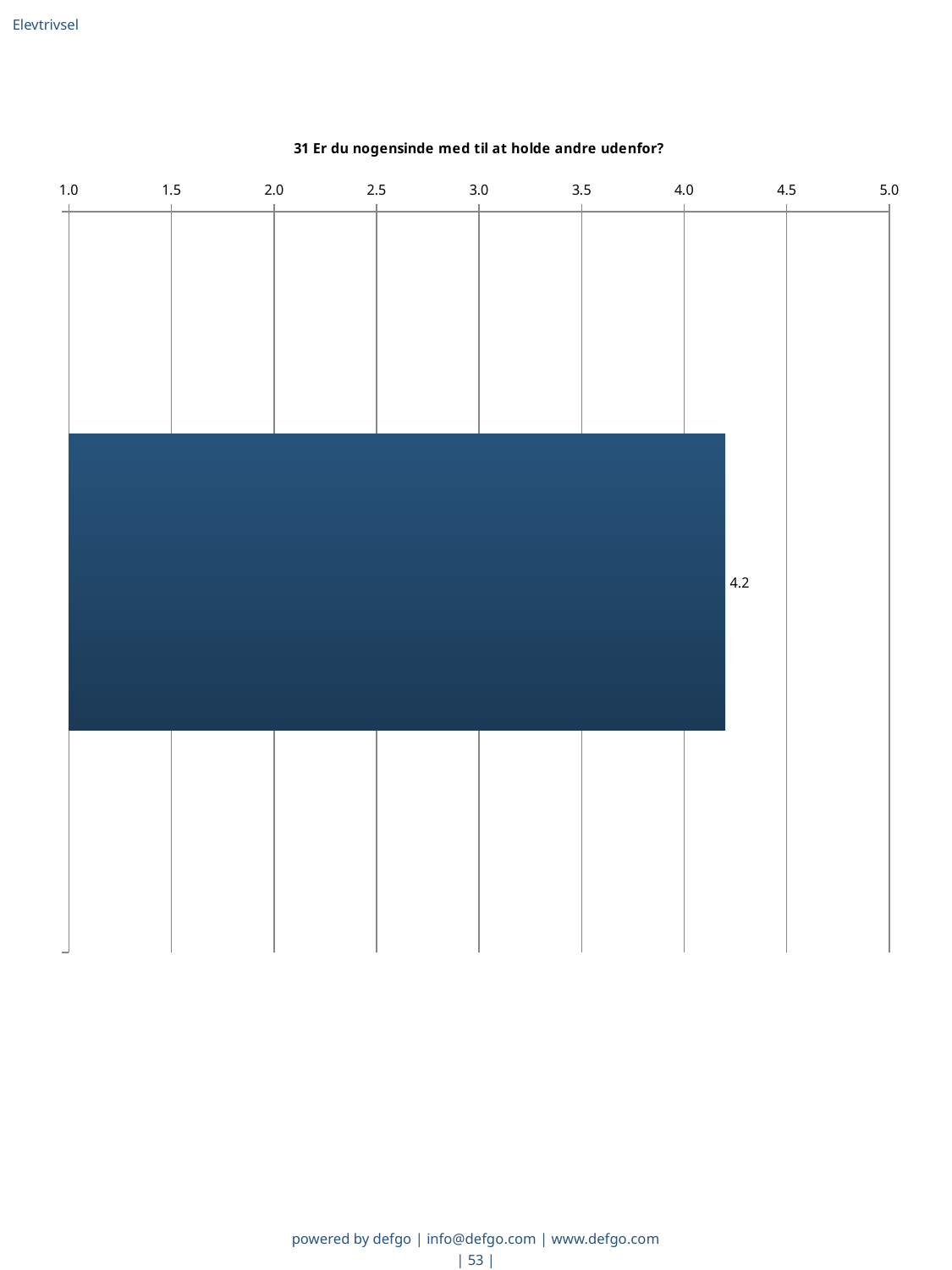
Is the value of the bar greater or less than 4.5? less What is the maximum value shown on the chart's axis? 5.0 How many bars are plotted in the chart? 1 What kind of chart is shown on the slide? bar chart What is the title of the chart? 31 Er du nogensinde med til at holde andre udenfor? Is the value of the bar greater or less than 4.0? greater Is the value of the bar greater or less than 3.0? greater What is the value shown by the bar in the chart? 4.2